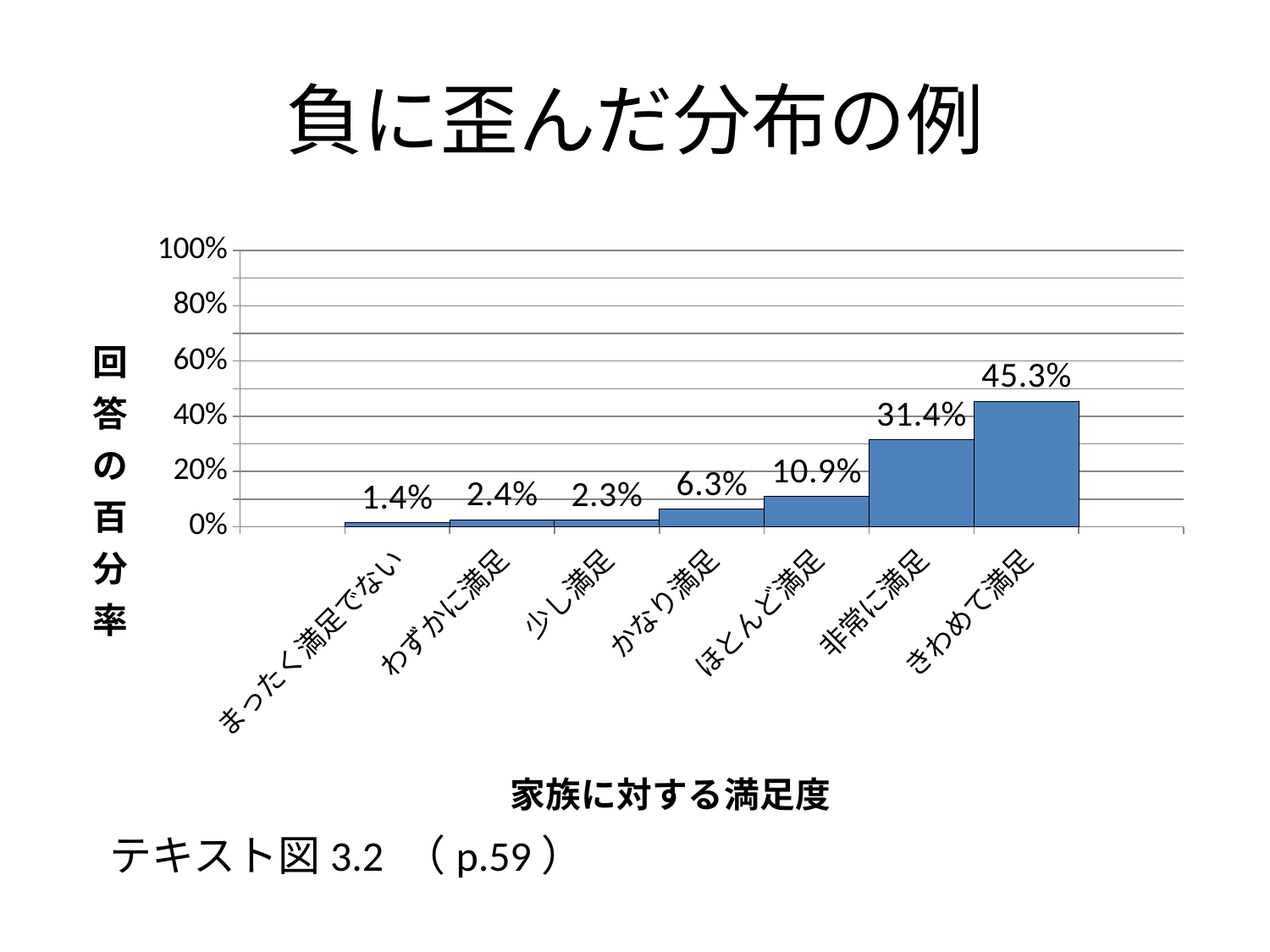
What is the value for きわめて満足? 45.3% Which is larger, the value for ほとんど満足 or the value for かなり満足? ほとんど満足 Which category has the highest value? きわめて満足 What is the value for まったく満足でない? 1.4% Which category has the lowest value? まったく満足でない Is the value for 非常に満足 greater or less than 20%? greater How many categories are shown on the x axis? 7 What is the x-axis title of the chart? 家族に対する満足度 What is the difference between the values for きわめて満足 and 非常に満足? 13.9% What is the value for かなり満足? 6.3% What kind of chart is shown on the slide? bar chart What is the value for 非常に満足? 31.4%